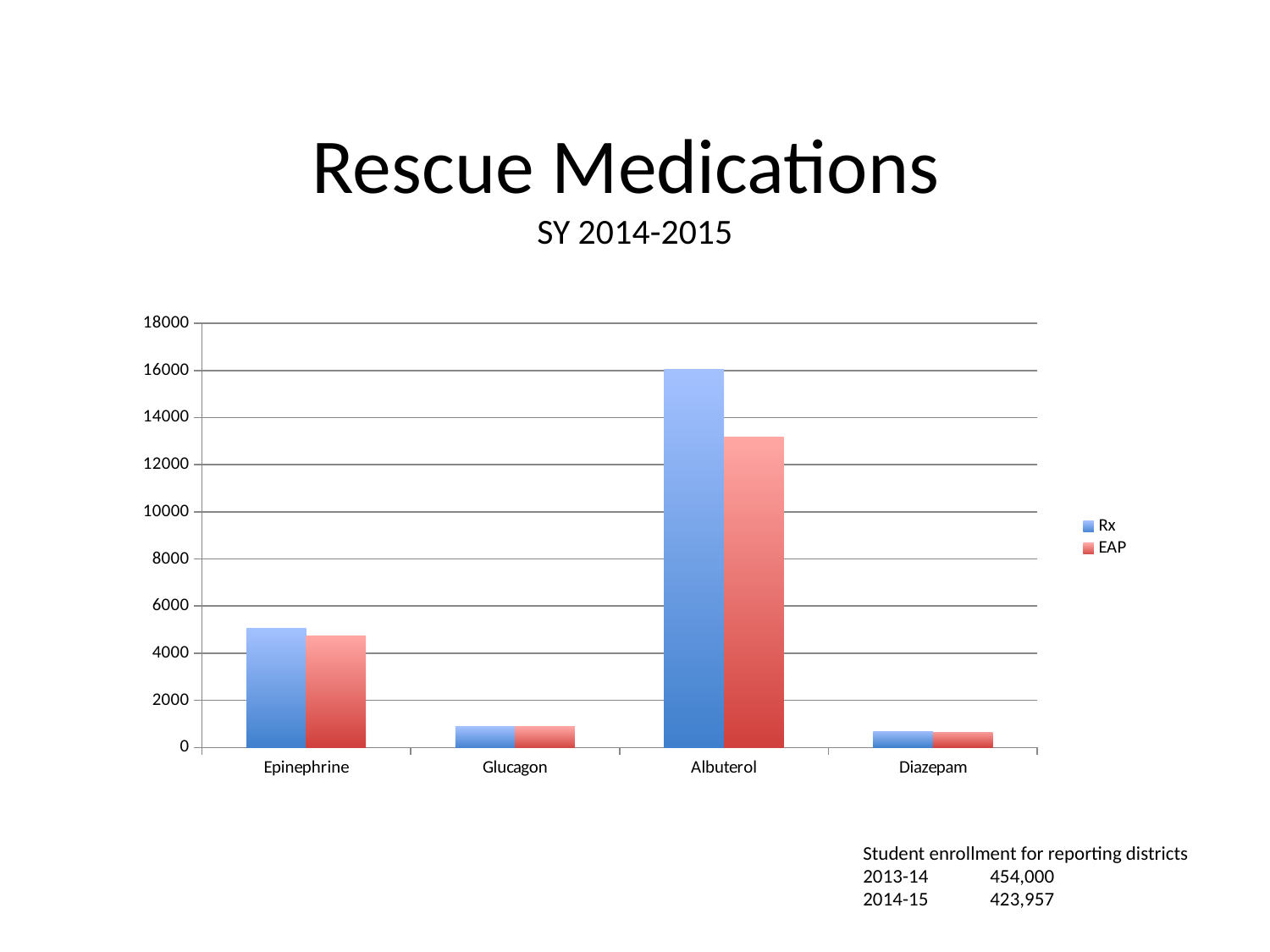
How many series does the legend list? 2 Is the EAP value for Albuterol greater or less than 14000? less Which medication has the highest EAP value? Albuterol What are the two series named in the legend? Rx and EAP What kind of chart is shown on the slide? bar chart Which medication has the highest Rx value? Albuterol How many medication categories are shown on the x axis? 4 Is the Rx value for Albuterol greater or less than 14000? greater Is the Rx value for Glucagon greater or less than 2000? less For Epinephrine, which is larger, the Rx value or the EAP value? Rx For Albuterol, which is larger, the Rx value or the EAP value? Rx